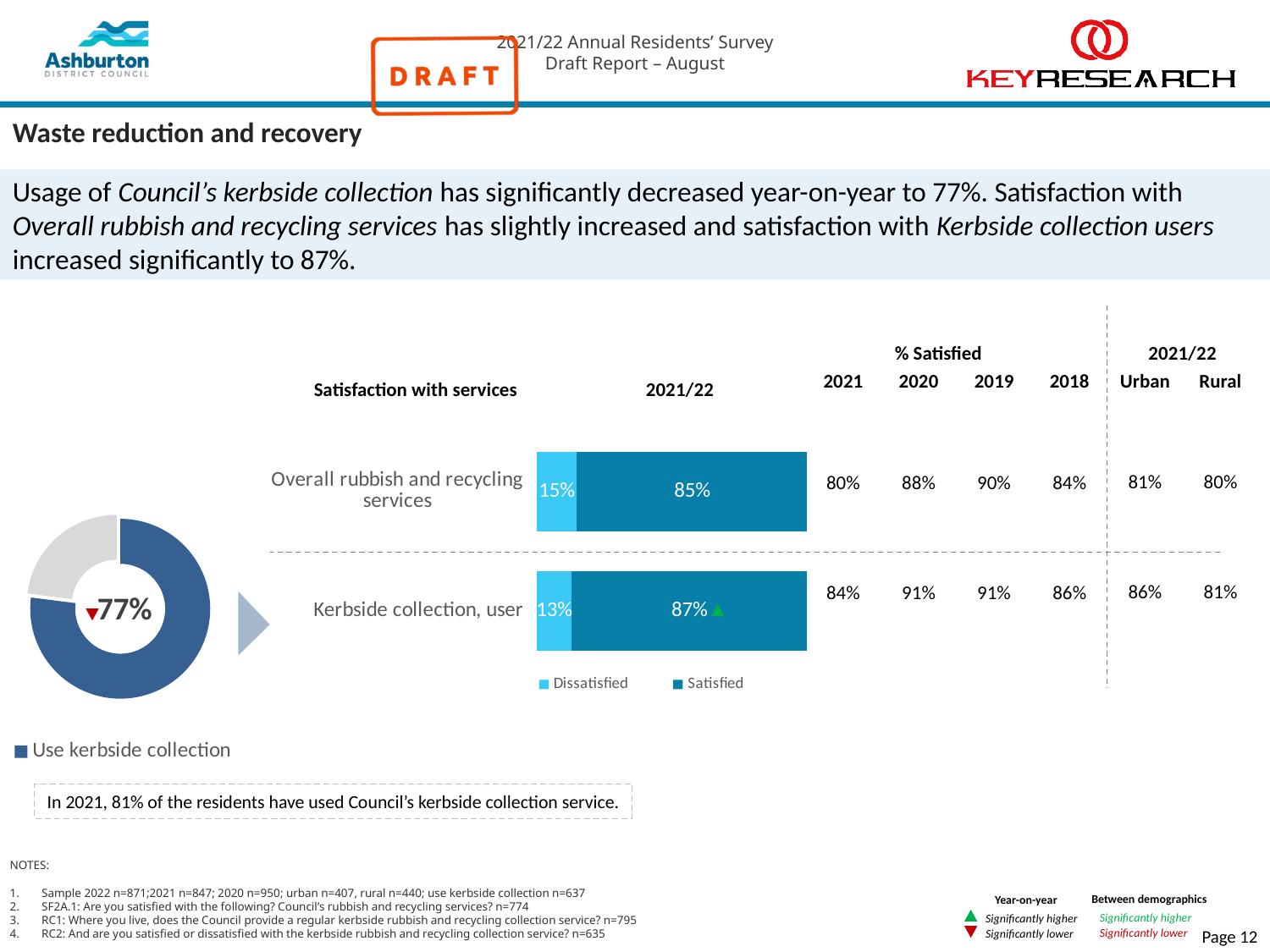
In the stacked bar chart of satisfaction with services, what is the difference between the satisfied percentages for Kerbside collection, user and Overall rubbish and recycling services? 2% In the stacked bar chart of satisfaction with services, what percentage were dissatisfied with Overall rubbish and recycling services in 2021/22? 15% In the stacked bar chart of satisfaction with services, what percentage were satisfied with Overall rubbish and recycling services in 2021/22? 85% In the stacked bar chart of satisfaction with services, which category has the higher satisfied percentage? Kerbside collection, user In the donut chart on the left, what percentage of residents use kerbside collection? 77% In the stacked bar chart of satisfaction with services, what percentage of Kerbside collection users were satisfied in 2021/22? 87% In the stacked bar chart of satisfaction with services, how many service categories are shown? 2 In the stacked bar chart of satisfaction with services, what percentage of Kerbside collection users were dissatisfied in 2021/22? 13% What kind of chart is used to show satisfaction with services for 2021/22? Stacked bar chart In the stacked bar chart of satisfaction with services, what are the two legend entries? Dissatisfied and Satisfied In the stacked bar chart of satisfaction with services, how many series does the legend list? 2 What kind of chart shows the share of residents who use kerbside collection? Donut chart